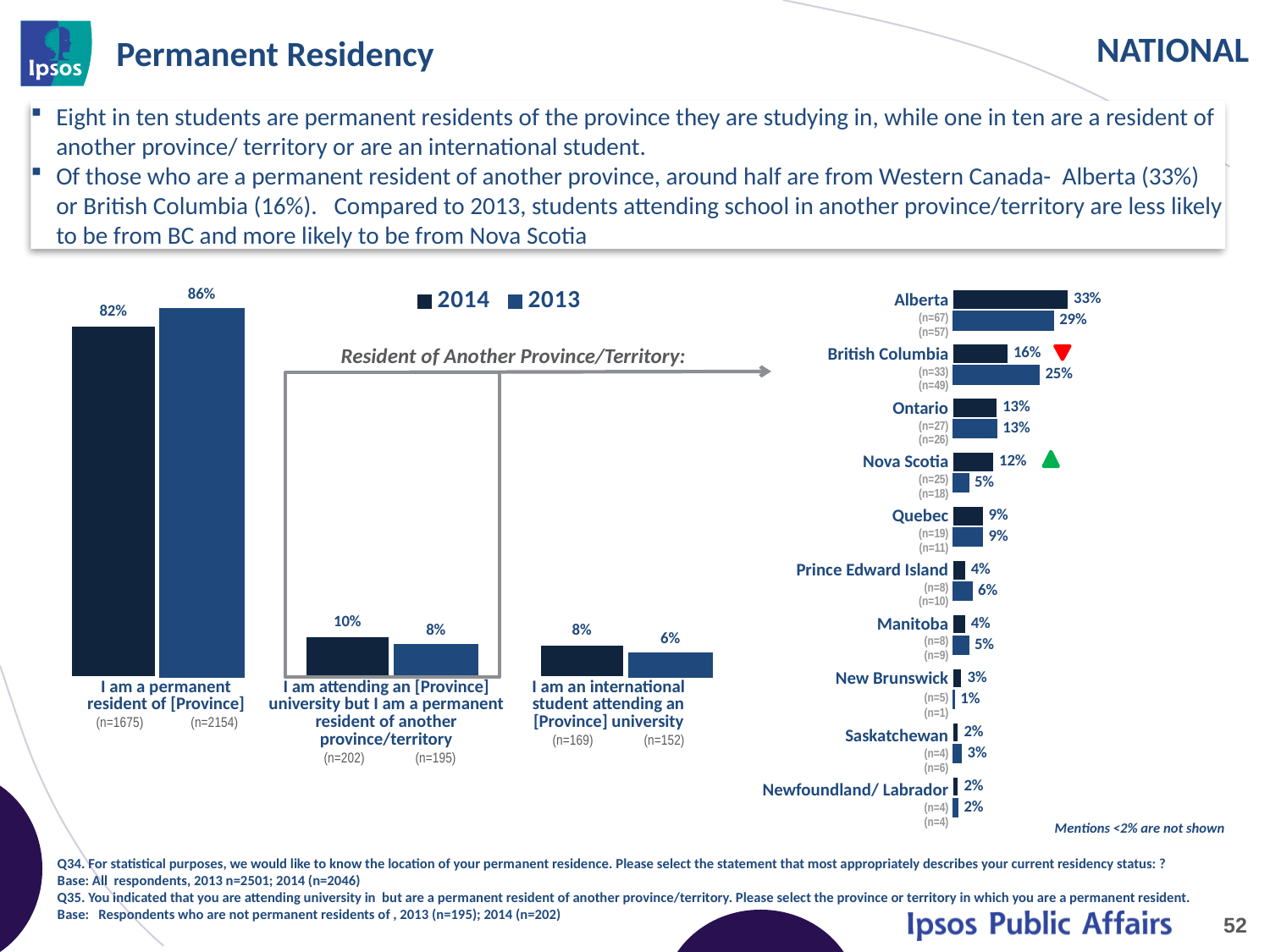
In the 'Resident of Another Province/Territory' chart on the right, which province has the highest 2014 value? Alberta In the 'Resident of Another Province/Territory' chart on the right, which is larger for British Columbia: the 2014 value or the 2013 value? 2013 In the 'Resident of Another Province/Territory' chart on the right, how many provinces/territories are listed? 10 In the 'Resident of Another Province/Territory' chart on the right, what is the 2014 value for Alberta? 33% What kind of chart is the chart on the right showing provinces? Bar chart In the 'Resident of Another Province/Territory' chart on the right, what is the 2013 value for British Columbia? 25% In the left bar chart, which is larger for 'I am attending an [Province] university but I am a permanent resident of another province/territory': the 2014 value or the 2013 value? 2014 In the left bar chart, what is the 2014 value for 'I am a permanent resident of [Province]'? 82% In the left bar chart, what is the difference between the 2013 and 2014 values for 'I am a permanent resident of [Province]'? 4 percentage points In the 'Resident of Another Province/Territory' chart on the right, what is the difference between the 2014 and 2013 values for Nova Scotia? 7 percentage points In the left bar chart, what is the 2013 value for 'I am an international student attending an [Province] university'? 6% How many series does the legend list? 2